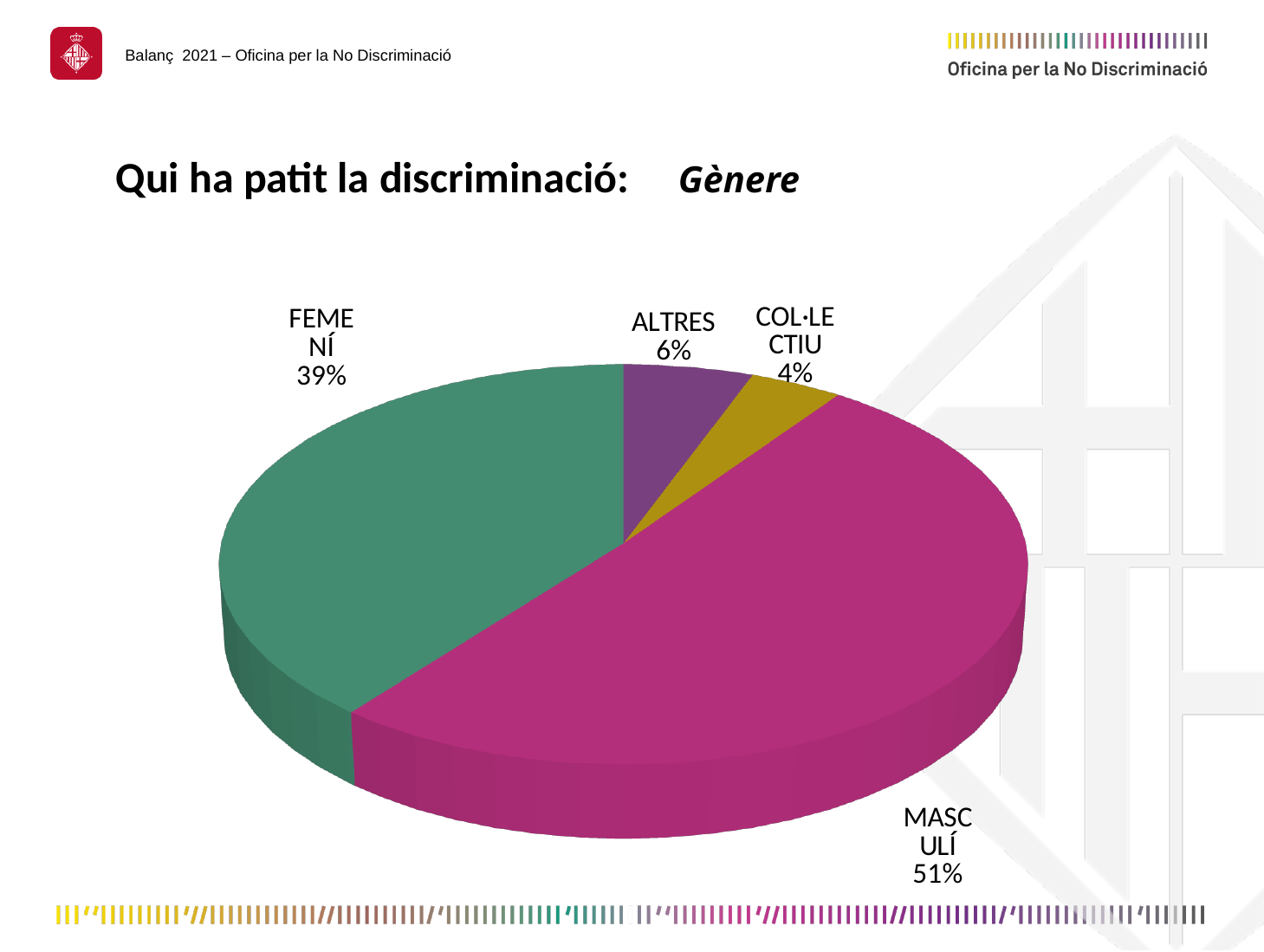
What percentage is shown for FEMENÍ? 39% What is the difference in percentage points between MASCULÍ and FEMENÍ? 12 Which category has the smallest slice of the pie? COL·LECTIU What share of the pie does MASCULÍ represent? 51% What percentage is shown for COL·LECTIU? 4% What percentage is shown for ALTRES? 6% What colour is the MASCULÍ slice? Magenta Which is larger, the share for ALTRES or the share for COL·LECTIU? ALTRES What is the combined share of ALTRES and COL·LECTIU? 10% How many categories are shown in the pie chart? 4 What kind of chart is shown on the slide? Pie chart Which category has the largest slice of the pie? MASCULÍ